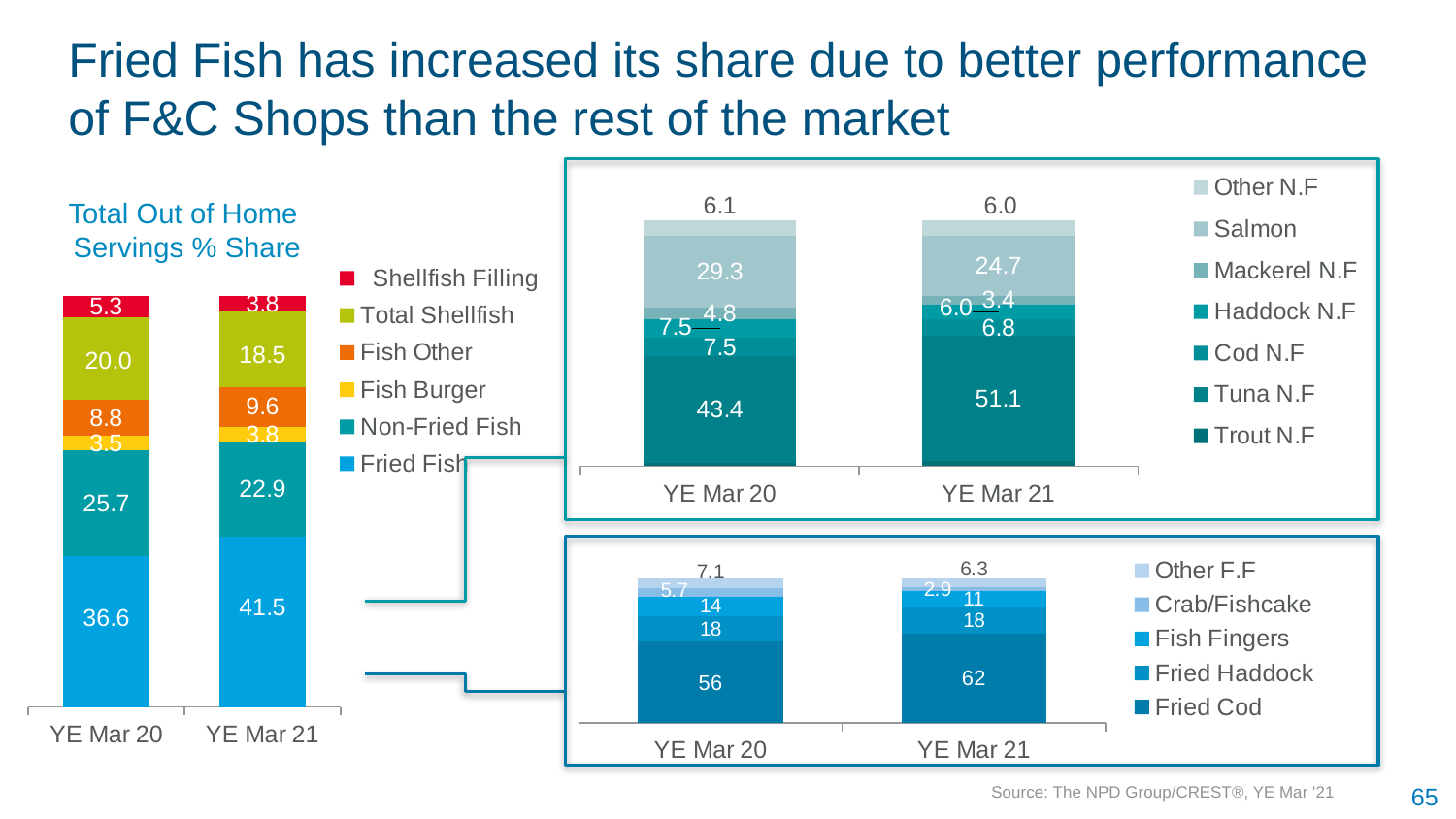
In the Total Out of Home Servings % Share chart, which segment is the smallest in YE Mar 21? Fish Burger and Shellfish Filling (both 3.8) In the bottom-right chart (Fried Fish breakdown), what is the value for Fried Cod in YE Mar 20? 56 In the Total Out of Home Servings % Share chart, by how much did the Fried Fish value change from YE Mar 20 to YE Mar 21? 4.9 In the bottom-right chart (Fried Fish breakdown), what is the difference between the Fried Cod values for YE Mar 21 and YE Mar 20? 6 In the top-right chart (Non-Fried Fish breakdown), what is the value for Salmon in YE Mar 20? 29.3 How many series does the legend of the Total Out of Home Servings % Share chart list? 6 In the Total Out of Home Servings % Share chart, which segment is the largest in YE Mar 20? Fried Fish In the Total Out of Home Servings % Share chart, what is the value for Non-Fried Fish in YE Mar 20? 25.7 What type of chart is the bottom-right chart (Fried Fish breakdown)? Stacked bar chart In the Total Out of Home Servings % Share chart, what is the value for Fried Fish in YE Mar 21? 41.5